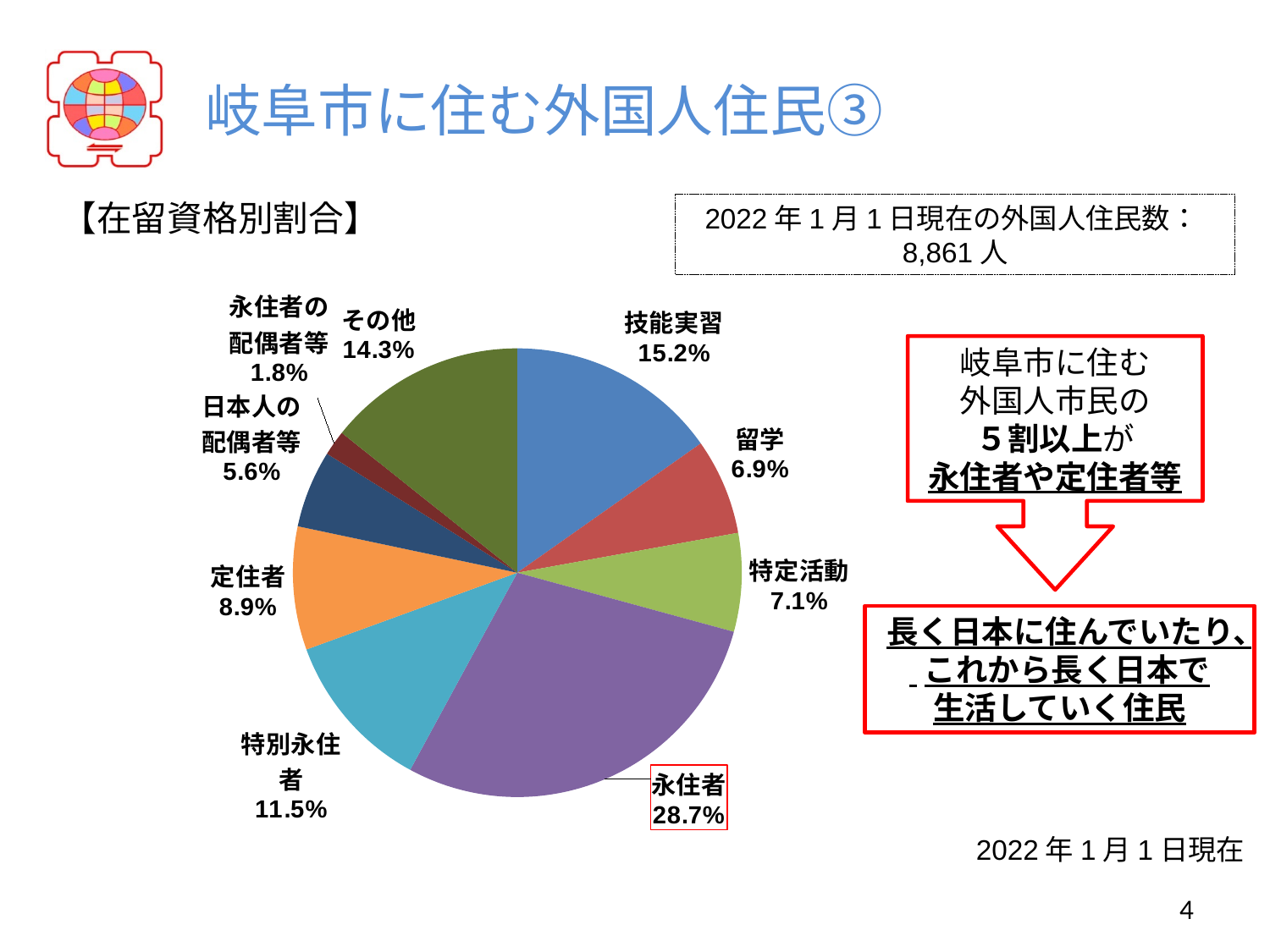
What is the difference in percentage points between その他 and 特定活動? 7.2 What is the difference in percentage points between 永住者 and 特別永住者? 17.2 Which is larger, the slice for 定住者 or the slice for 留学? 定住者 What kind of chart is shown on the slide? pie chart What is the total number of foreign residents stated in the box at the top right of the slide? 8,861 人 What is the value shown for 特別永住者? 11.5% What is the value shown for 日本人の配偶者等? 5.6% What is the value shown for 技能実習? 15.2% How many categories are shown in the pie chart? 9 What share of the pie does 永住者 hold? 28.7% Which category has the largest slice of the pie? 永住者 Which category has the smallest slice of the pie? 永住者の配偶者等